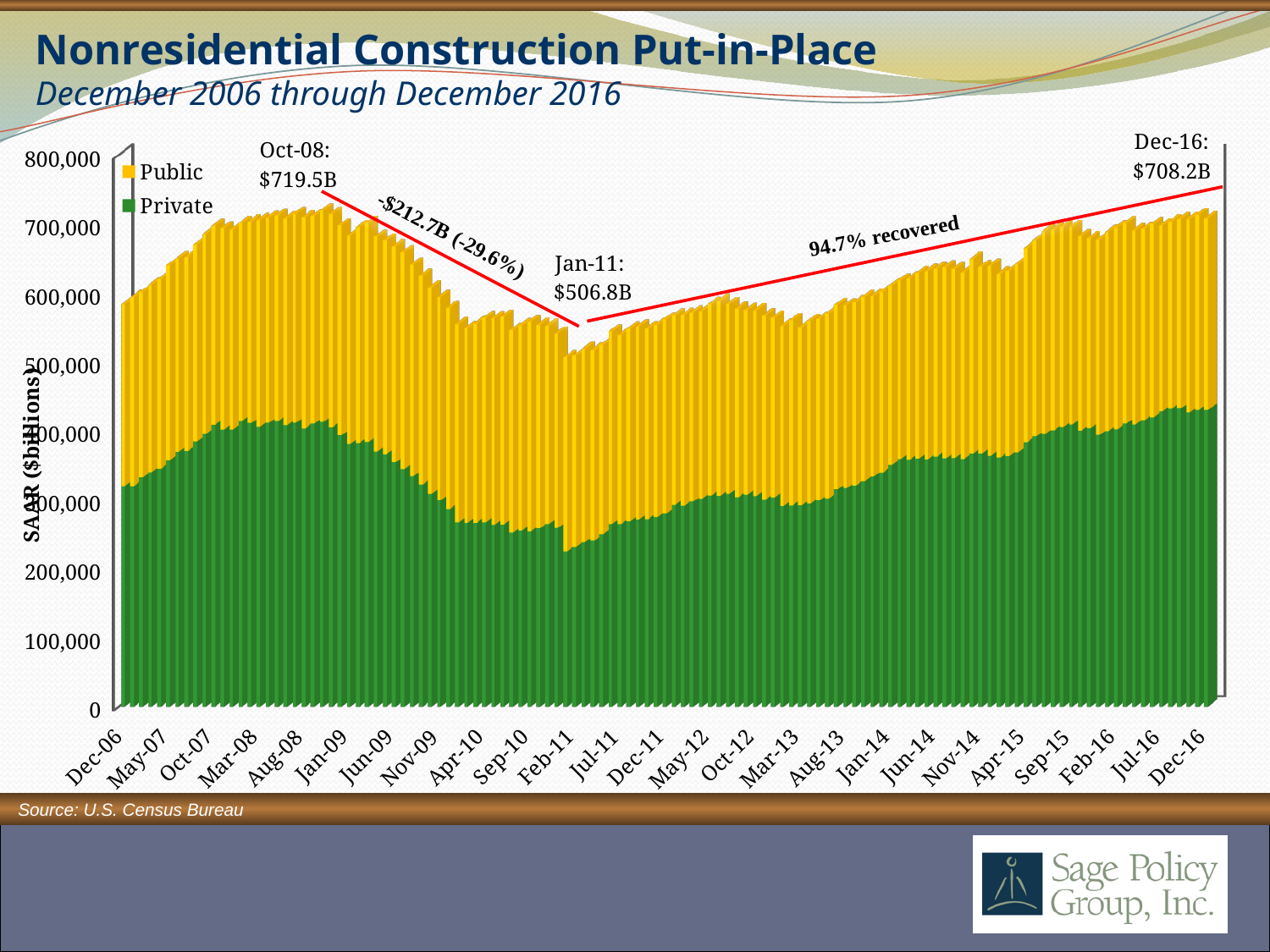
Which colour represents the Public series in the legend? Yellow Which is larger, the annotated total for Oct-08 or for Dec-16? Oct-08 Is the Private value for Dec-16 greater or less than 400,000? greater What total value is annotated for Jan-11? $506.8B What kind of chart is shown on the slide? Stacked bar chart By how much did the total fall from Oct-08 to Jan-11, according to the annotation? $212.7B (-29.6%) What total value is annotated for Oct-08? $719.5B Do the total values rise or fall between Oct-08 and Jan-11? Fall Is the Private value for Dec-06 greater or less than 400,000? less What total value is annotated for Dec-16? $708.2B How many series does the legend list? 2 What percentage of the decline is annotated as recovered by Dec-16? 94.7%